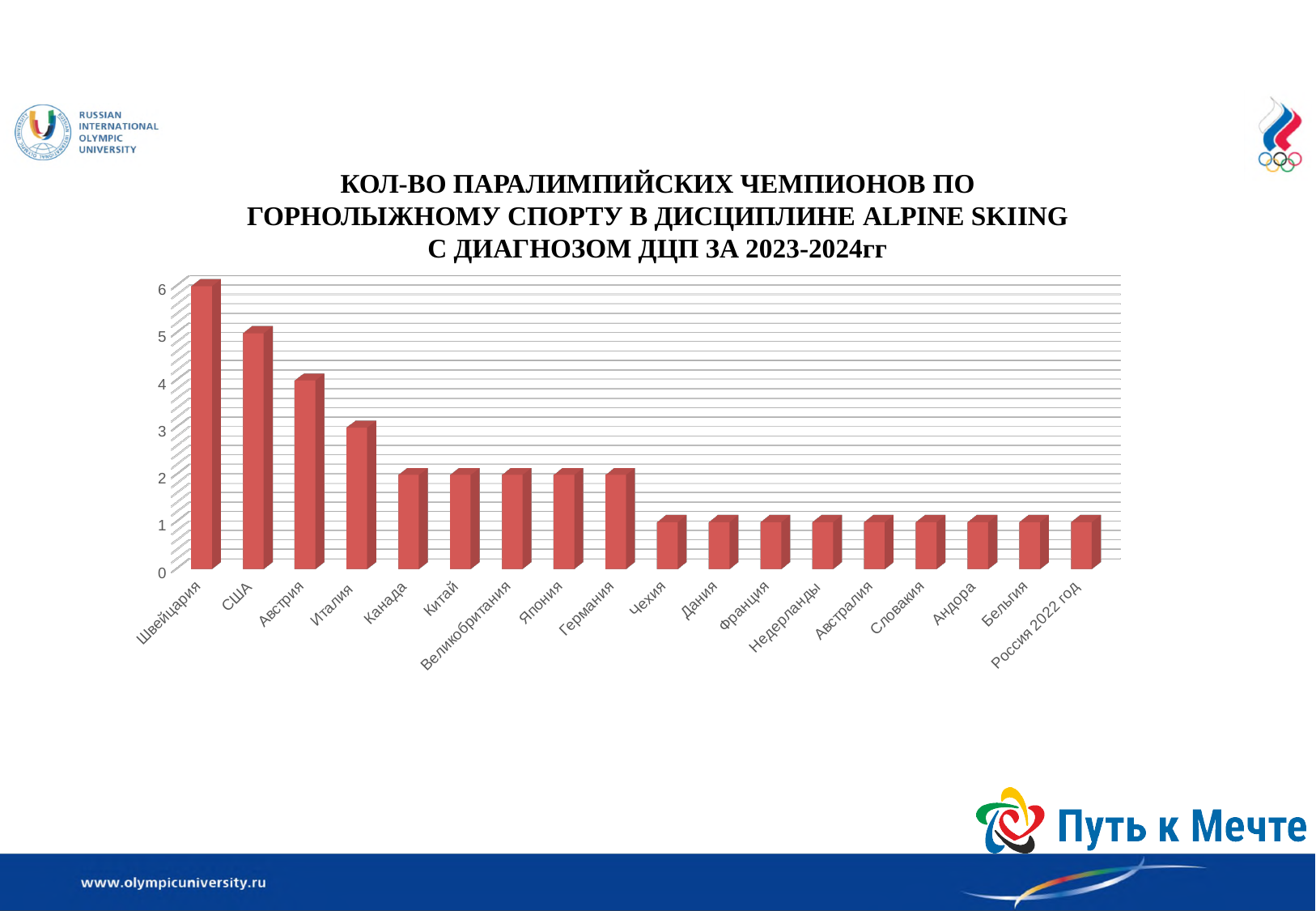
What is the value for Австрия? 4 What is the value for Россия 2022 год? 1 How many countries (categories) are shown on the x axis of the chart? 18 Which country has the highest number of Paralympic champions in the chart? Швейцария Which is larger, the value for Австрия or the value for Канада? Австрия What is the value for Италия? 3 What is the value for Германия? 2 What is the value for США? 5 What is the value for Швейцария? 6 Do the values rise or fall moving from left to right along the x axis? fall What is the difference between the values for Швейцария and США? 1 What type of chart is shown on the slide? bar chart